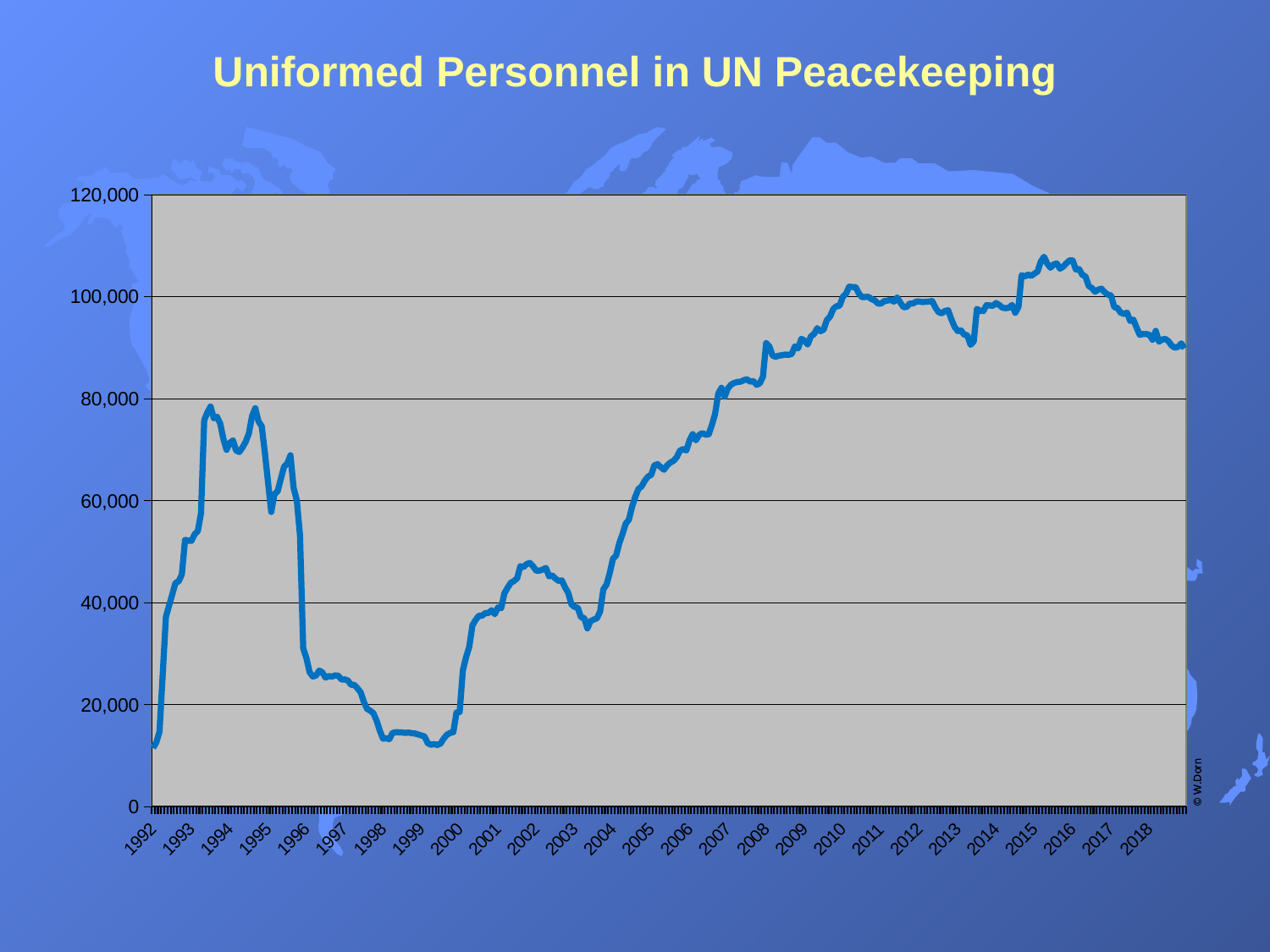
Is the value in 1999 greater or less than 20,000? less Is the value in 2010 larger or smaller than the value in 2000? larger Is the value in 1997 greater or less than 40,000? less What is the title of the chart? Uniformed Personnel in UN Peacekeeping How many year labels are shown along the x axis? 27 Is the value in 2005 greater or less than 40,000? greater What kind of chart is shown on the slide? line chart Does the line rise or fall between 2004 and 2010? rise Does the line rise or fall between 2016 and 2018? fall